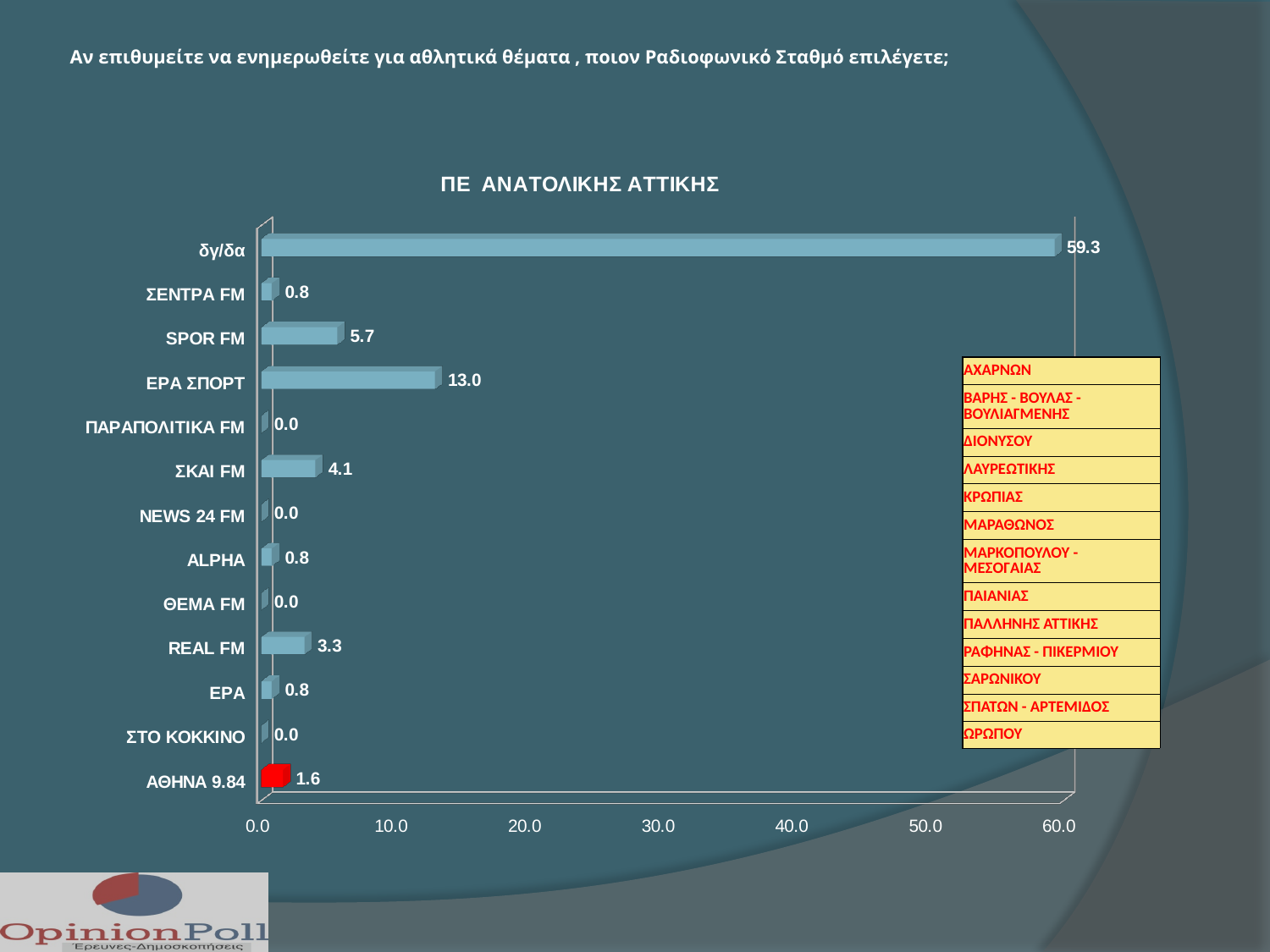
Is the value for δγ/δα greater or less than 50.0? greater Which category has the highest value? δγ/δα What kind of chart is shown? bar chart How many categories are shown on the chart? 13 What is the difference between the values for ΕΡΑ ΣΠΟΡΤ and SPOR FM? 7.3 How many categories have a value of 0.0? 4 What is the title of the chart? ΠΕ ΑΝΑΤΟΛΙΚΗΣ ΑΤΤΙΚΗΣ What is the value for ΕΡΑ ΣΠΟΡΤ? 13.0 What is the value for ΑΘΗΝΑ 9.84? 1.6 What is the value for SPOR FM? 5.7 Which is larger, the value for REAL FM or the value for ΣΚΑΙ FM? ΣΚΑΙ FM What is the value for ΣΚΑΙ FM? 4.1